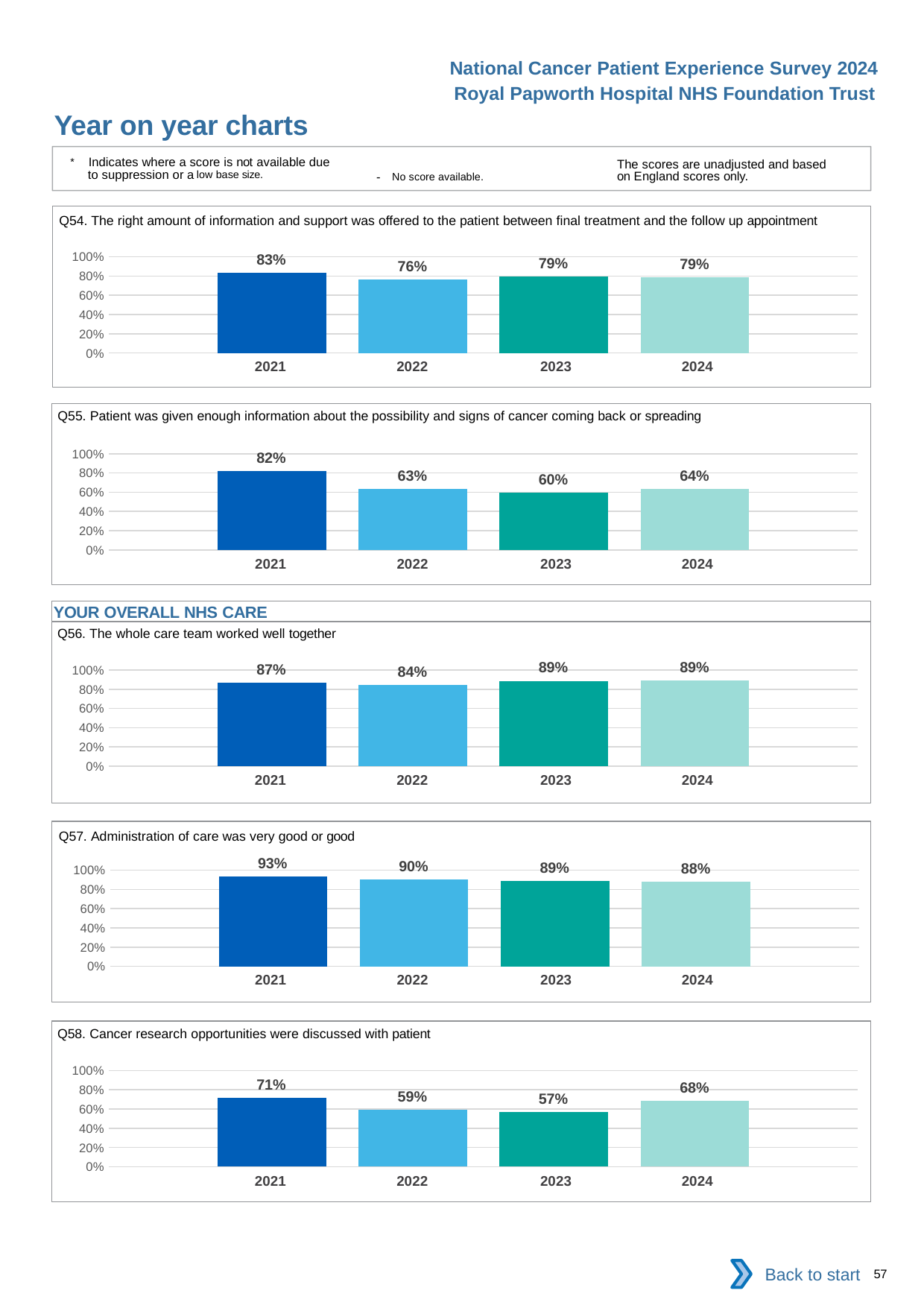
In the Q55 chart, what is the difference between the 2021 and 2022 values? 19% In the Q58 chart, what is the difference between the 2021 and 2023 values? 14% In the Q57 chart, which year has the highest value? 2021 How many years are shown in the Q54 chart? 4 In the Q58 chart, what is the value for 2024? 68% In the Q58 chart, which is larger, the value for 2022 or the value for 2023? 2022 In the Q54 chart, what is the value for 2021? 83% What is the section heading shown above the Q56 chart? YOUR OVERALL NHS CARE What kind of chart is the Q56 chart? bar chart In the Q56 chart, what is the value for 2022? 84% In the Q57 chart, do the values rise or fall from 2021 to 2024? fall In the Q55 chart, which year has the lowest value? 2023